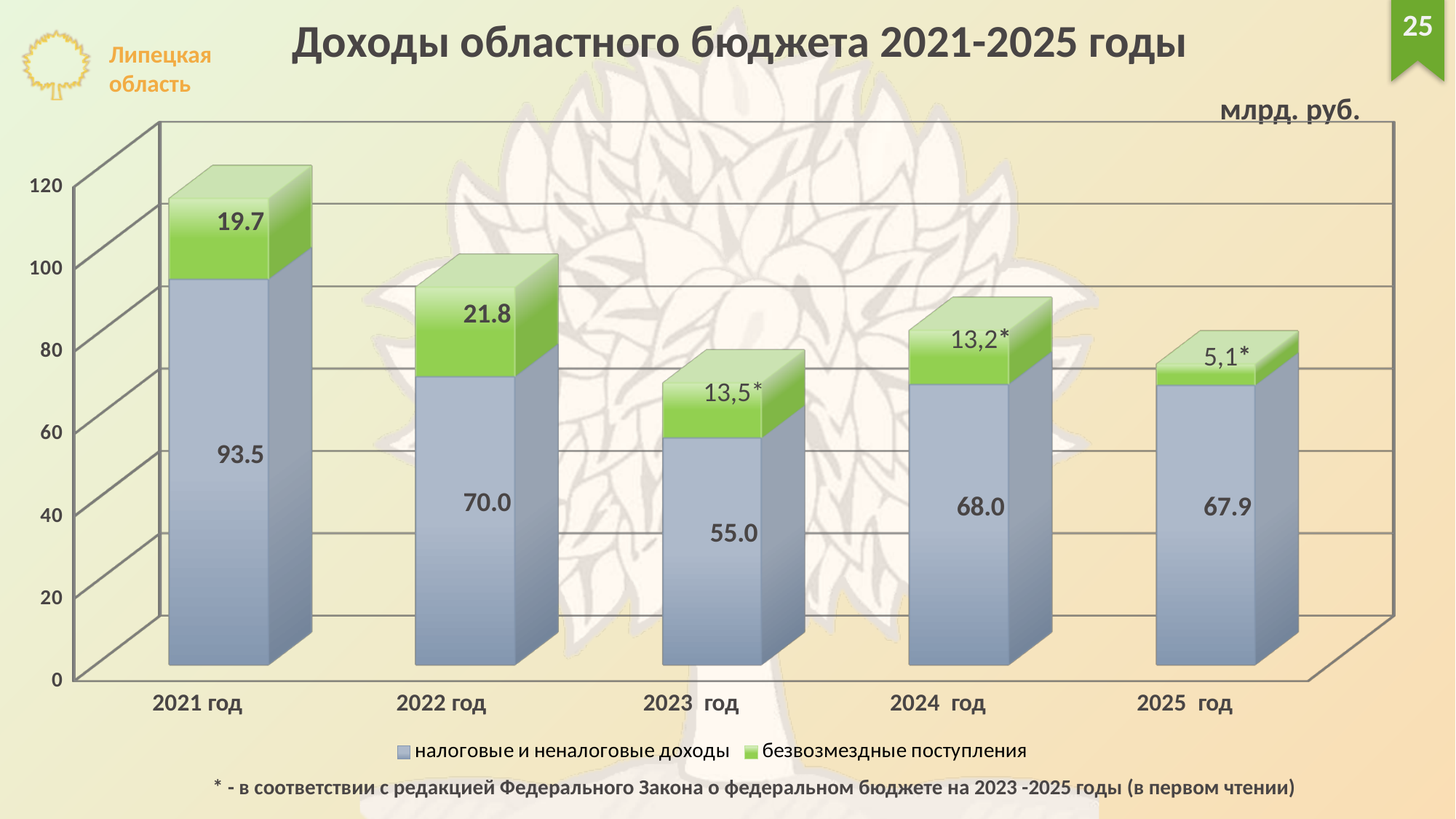
How many years are shown on the x axis? 5 How many series does the legend list? 2 What is the value of налоговые и неналоговые доходы for 2021 год? 93.5 What kind of chart is shown on the slide? Stacked bar chart Which year has the highest value of налоговые и неналоговые доходы? 2021 год What unit is indicated above the chart? млрд. руб. Which is larger: безвозмездные поступления in 2021 год or in 2022 год? 2022 год What is the value of безвозмездные поступления for 2025 год? 5,1* What is the value of безвозмездные поступления for 2022 год? 21.8 Which year has the lowest value of безвозмездные поступления? 2025 год What is the difference between налоговые и неналоговые доходы in 2021 год and 2022 год? 23.5 What is the total of the stacked bar for 2021 год? 113.2